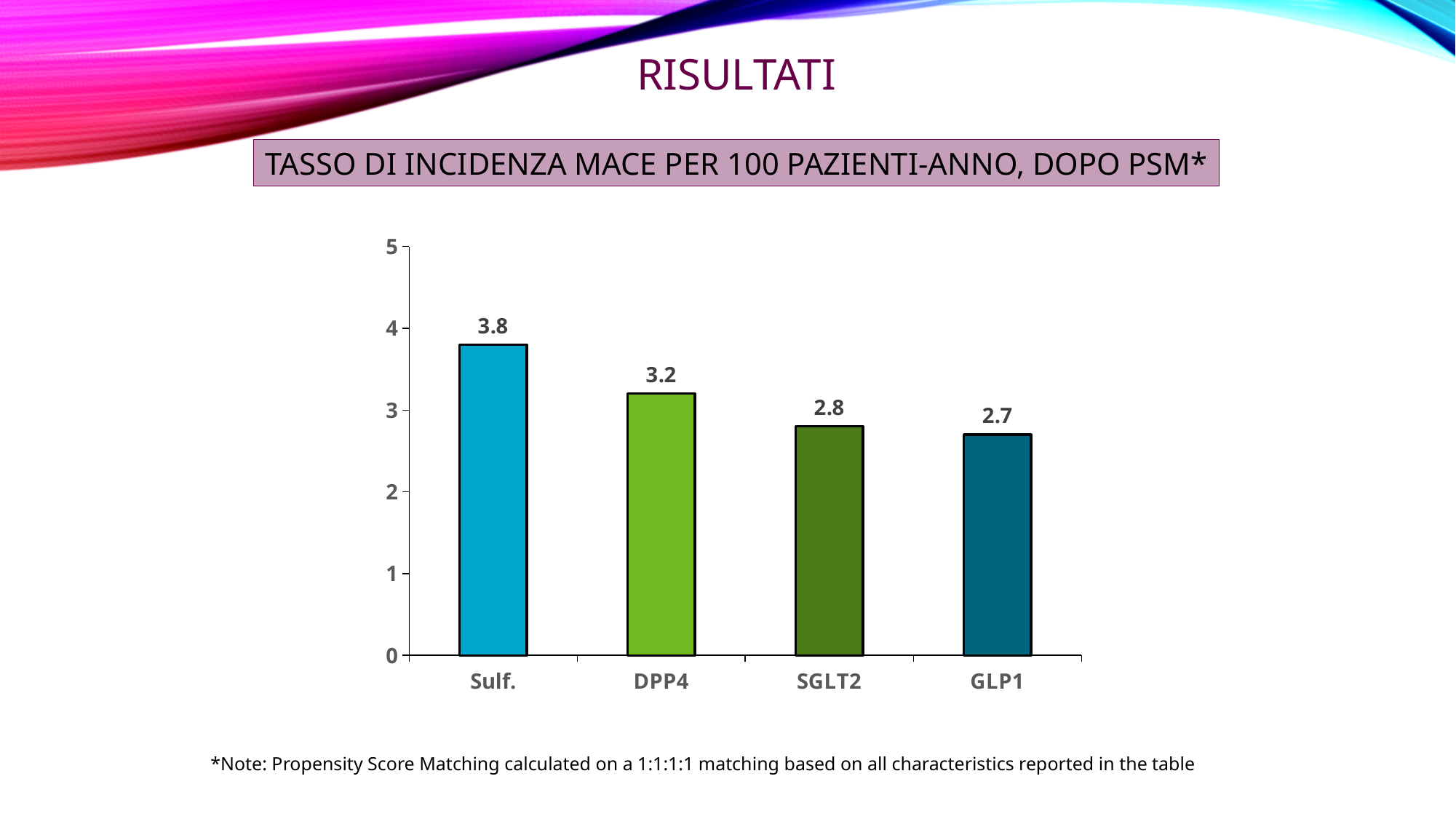
Which category has the lowest MACE incidence rate? GLP1 What is the MACE incidence rate per 100 patient-years for Sulf.? 3.8 What is the value shown for SGLT2? 2.8 Which has a higher value, DPP4 or SGLT2? DPP4 What is the difference between the values for Sulf. and GLP1? 1.1 Which category has the highest MACE incidence rate? Sulf. What is the value shown for GLP1? 2.7 What is the value shown for DPP4? 3.2 What kind of chart is shown on the slide? Bar chart How many categories are shown on the x axis? 4 Do the values rise or fall from left to right along the x axis? Fall What is the difference between the values for DPP4 and SGLT2? 0.4